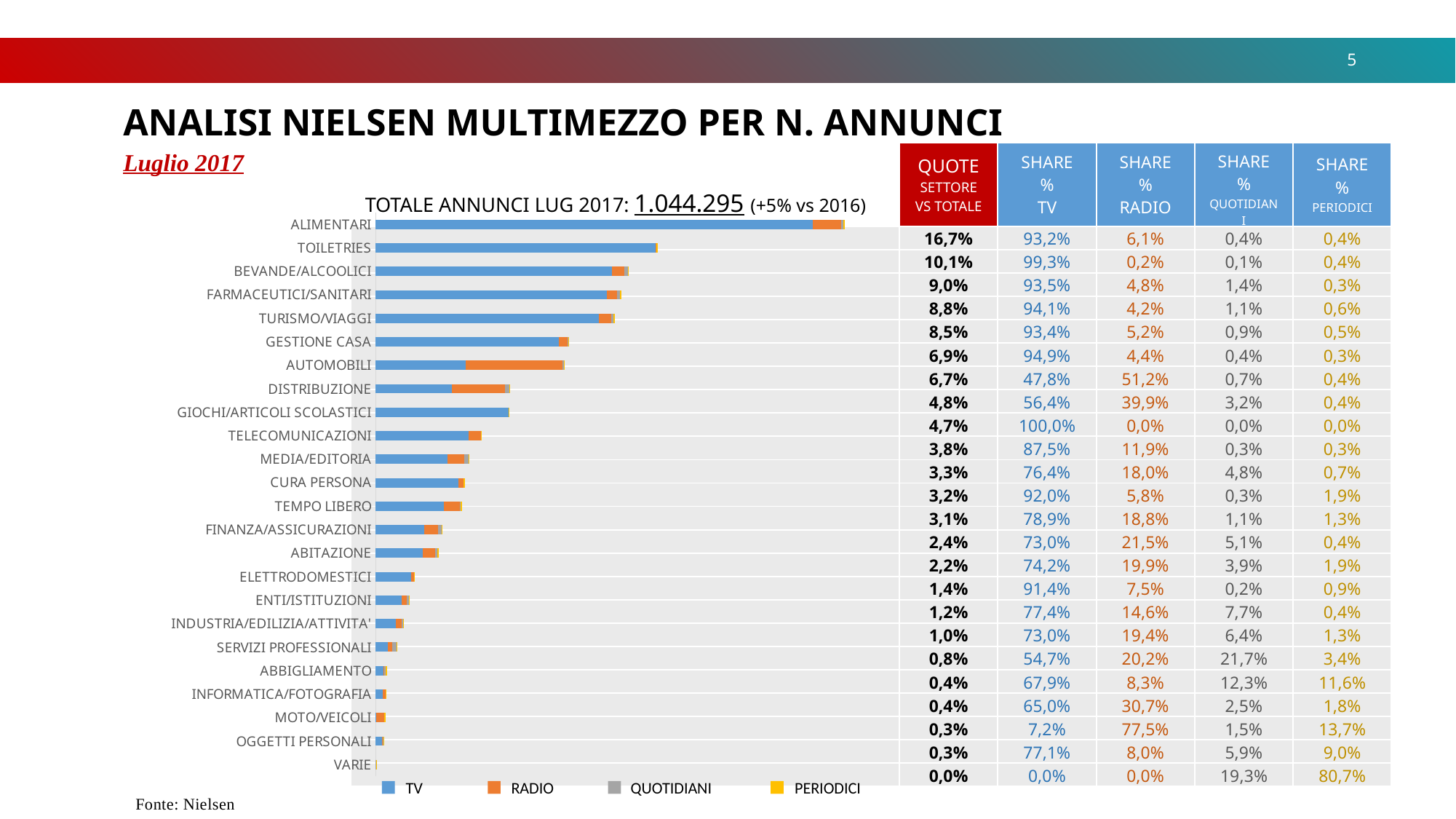
What is the difference between the QUOTE SETTORE VS TOTALE values of ALIMENTARI and TOILETRIES? 6,6% Which sector has the shortest bar in the chart? VARIE What is the total number of annunci for July 2017 stated above the chart? 1.044.295 What kind of chart is shown on the slide? bar chart What is the QUOTE SETTORE VS TOTALE value for ALIMENTARI? 16,7% Which sector has a longer bar, TOILETRIES or BEVANDE/ALCOOLICI? TOILETRIES How many sectors (categories) are listed in the bar chart? 24 What is the SHARE % RADIO value for MOTO/VEICOLI? 77,5% Which sector has the longest bar in the chart? ALIMENTARI How many series does the chart legend list? 4 Which sector has a longer bar, AUTOMOBILI or DISTRIBUZIONE? AUTOMOBILI What is the SHARE % TV value for DISTRIBUZIONE? 56,4%